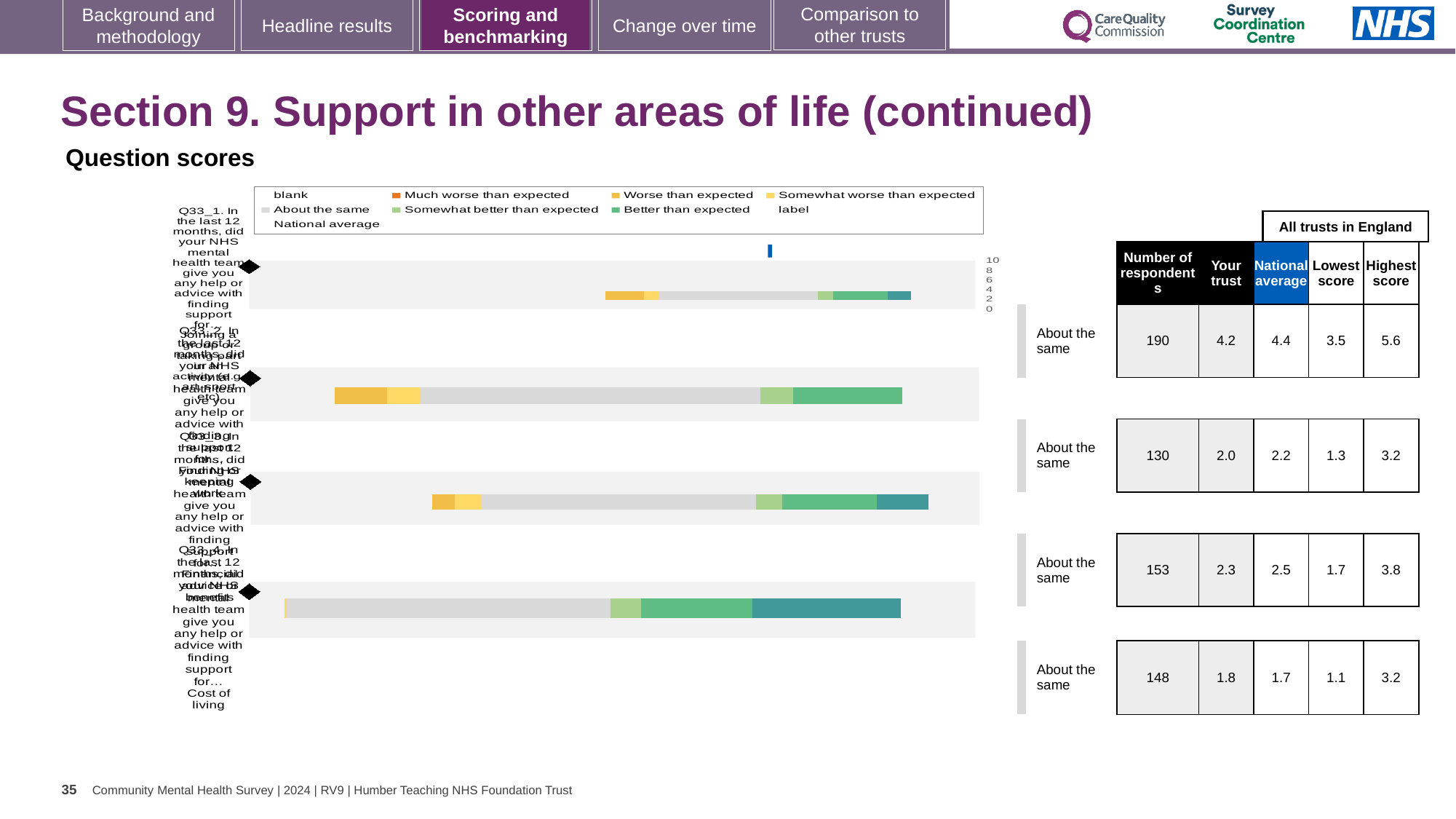
What is the 'Your trust' score for Q33_1? 4.2 What is the national average for Q33_1? 4.4 What benchmark category is shown next to each of the four question bars? About the same For Q33_1, which is larger: the 'Your trust' score or the national average? National average What is the difference between the highest score and the lowest score for Q33_1? 2.1 What is the highest score for the fourth question row (Q33_4)? 3.2 What kind of chart is shown under 'Question scores'? bar chart Which legend entry corresponds to the grey segments of the bars? About the same What is the lowest score for the second question row (Q33_2)? 1.3 Which question has the highest number of respondents? Q33_1 What is the number of respondents for Q33_1? 190 How many question bars are plotted in the chart? 4